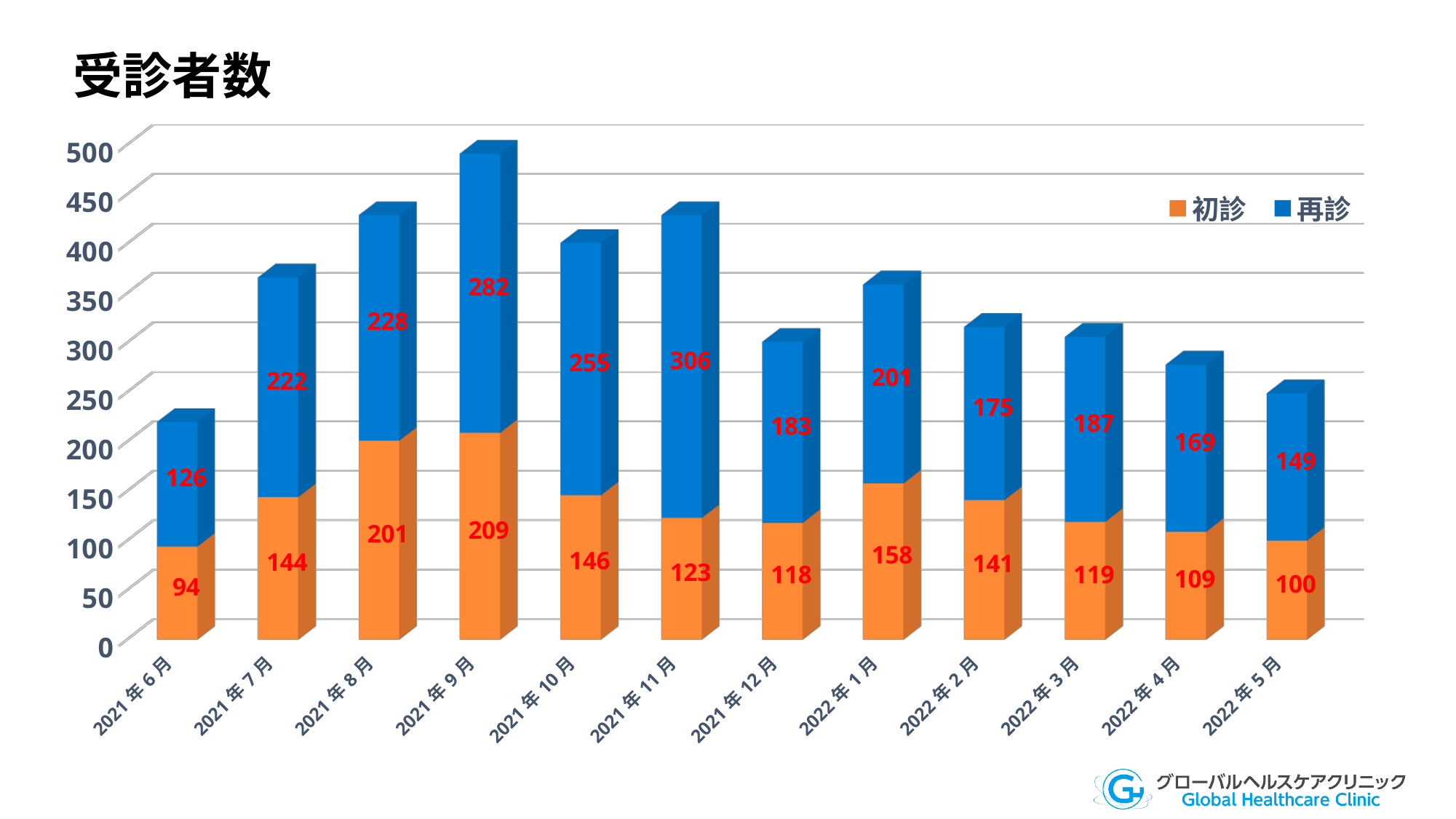
What is the total of the stacked bar for 2022年5月? 249 What is the title of the chart? 受診者数 What kind of chart is shown on the slide? Stacked bar chart What is the total of the stacked bar for 2021年9月? 491 How many months are shown on the x axis? 12 What is the difference between the 再診 values for 2021年9月 and 2021年6月? 156 Which is larger, the 初診 value for 2022年1月 or the 初診 value for 2022年2月? 2022年1月 What is the 再診 value for 2021年11月? 306 Which month has the lowest 初診 value? 2021年6月 Which month has the highest 再診 value? 2021年11月 What is the 初診 value for 2021年9月? 209 How many series does the legend list? 2